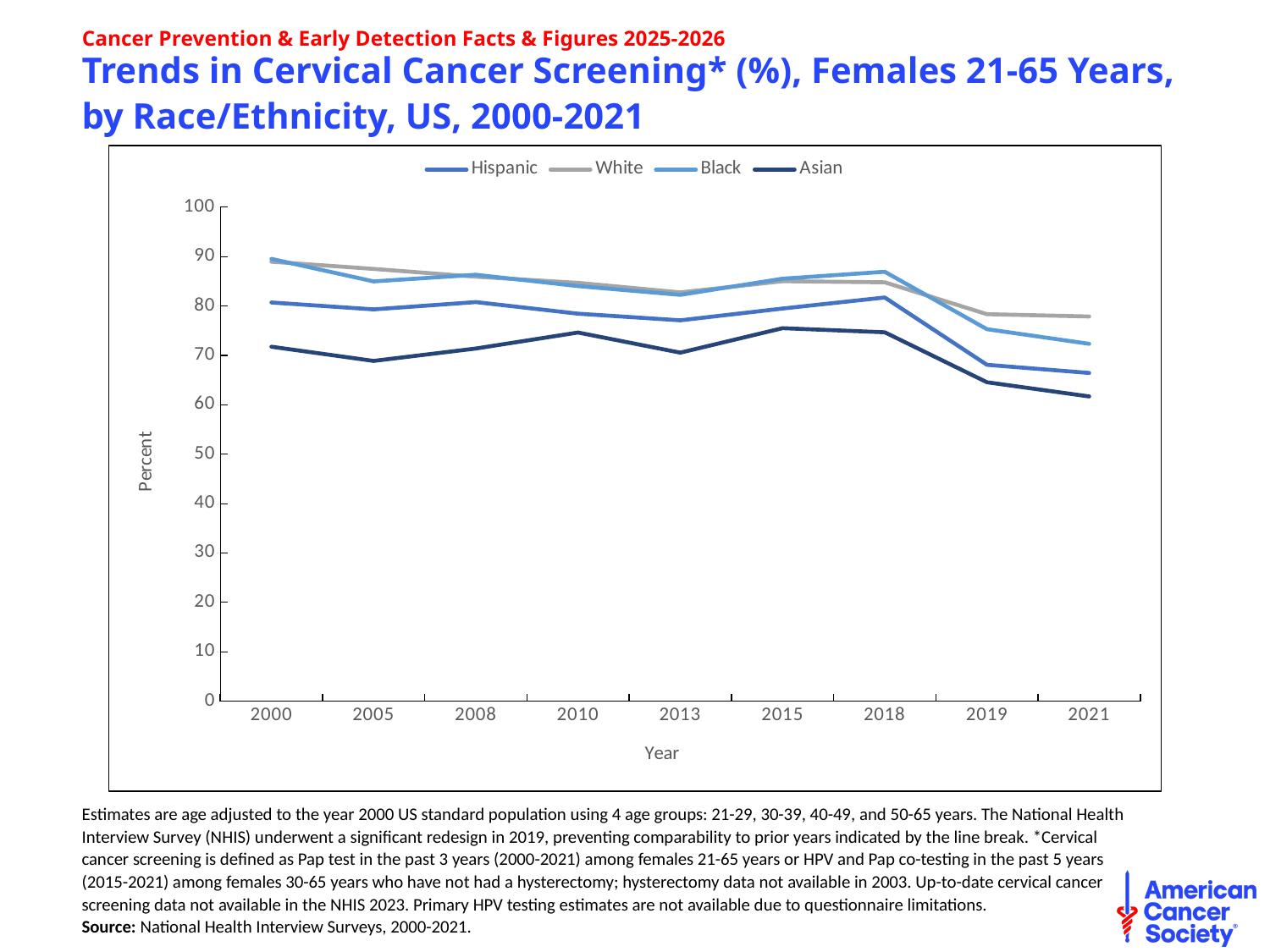
In which year is the Asian line at its lowest? 2021 Which race/ethnicity group has the highest screening percentage in 2021? White How many series does the legend list? 4 Is the value for Hispanic in 2019 greater or less than 70? less How many years are marked along the x axis? 9 What kind of chart is shown on the slide? Line chart What is the label on the y axis? Percent Is the value for White in 2000 greater or less than 80? greater Does the Asian line rise or fall from 2018 to 2021? fall In 2005, which is larger, the value for Hispanic or the value for Asian? Hispanic Which race/ethnicity group has the lowest screening percentage in 2021? Asian Is the value for Asian in 2021 greater or less than 70? less